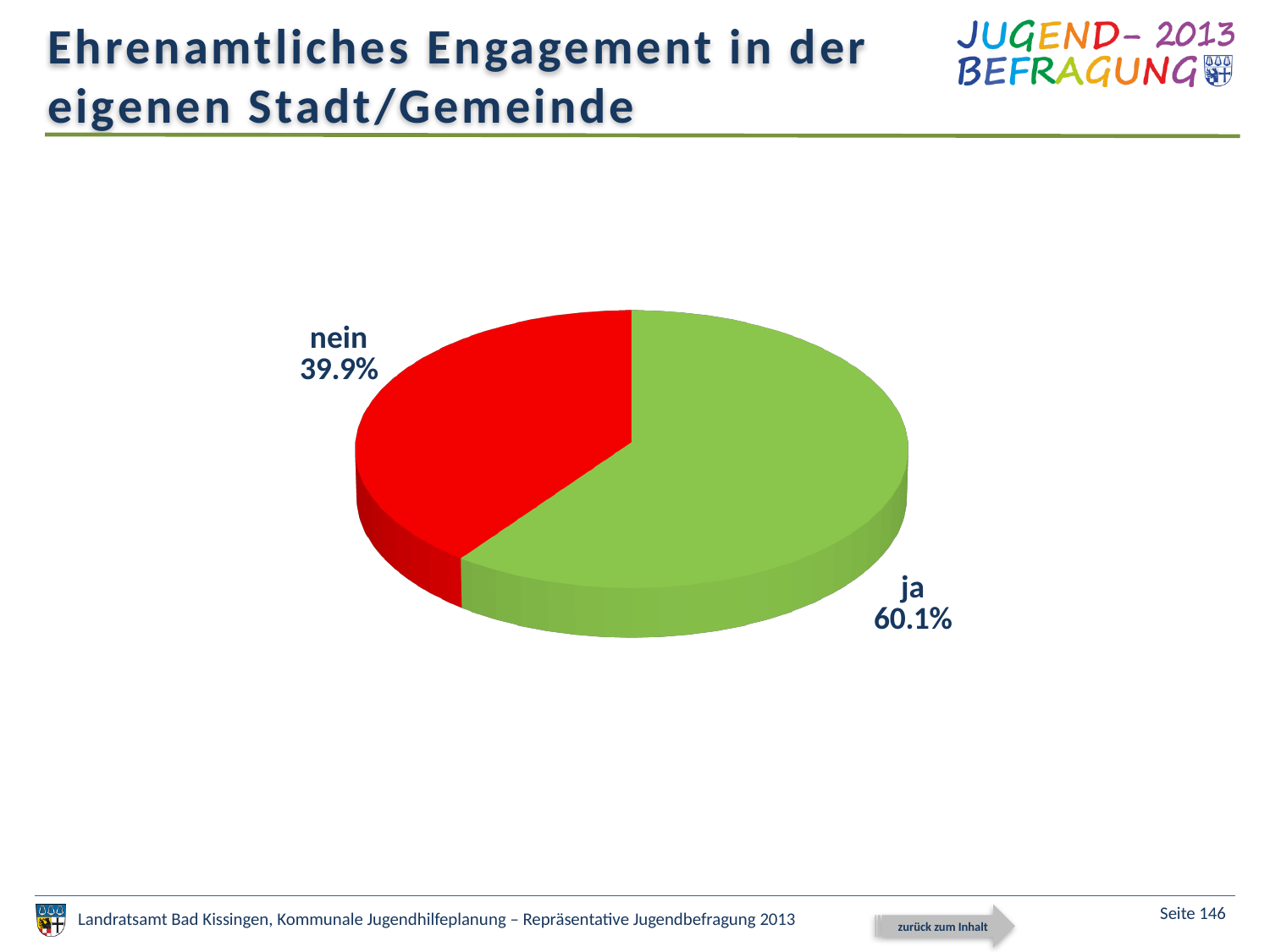
What kind of chart is shown on the slide? pie chart What colour is the "nein" slice? red Which slice of the pie is the largest? ja What share of the pie is labelled "ja"? 60.1% What is the difference in percentage points between the "ja" and "nein" slices? 20.2 Is the share for "nein" greater or less than 50%? less Which slice of the pie is the smallest? nein Which is larger, the "ja" slice or the "nein" slice? ja What share of the pie is labelled "nein"? 39.9% How many slices does the pie chart have? 2 Is the share for "ja" greater or less than 50%? greater What colour is the "ja" slice? green